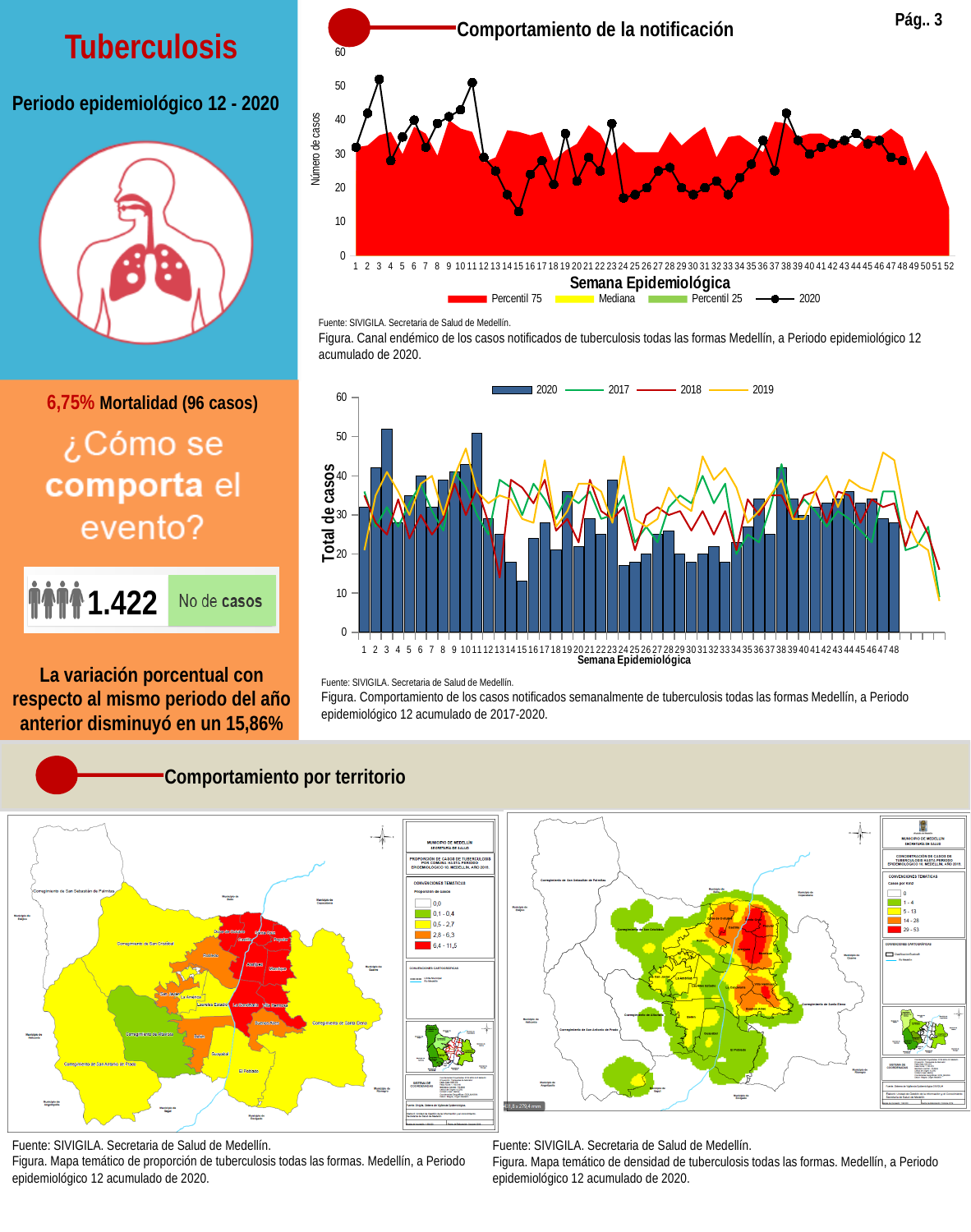
In the second chart (weekly cases 2017-2020), is the 2020 bar for week 14 greater or less than 20? less In the chart titled 'Comportamiento de la notificación', what are the legend entries? Percentil 75, Mediana, Percentil 25, 2020 In the second chart (weekly cases 2017-2020), how many series does the legend list? 4 In the second chart (weekly cases 2017-2020), which year is plotted as bars? 2020 In the second chart (weekly cases 2017-2020), is the 2020 bar for week 3 greater or less than 50? greater In the second chart (weekly cases 2017-2020), how many weeks are labelled on the x axis? 48 In the second chart (weekly cases 2017-2020), which week has the lowest 2020 bar? 15 In the chart titled 'Comportamiento de la notificación', is the 2020 value for week 3 greater or less than 50? greater In the chart titled 'Comportamiento de la notificación', how many series does the legend list? 4 In the second chart (weekly cases 2017-2020), which is larger for 2020: week 3 or week 15? week 3 In the chart titled 'Comportamiento de la notificación', what is the label of the x axis? Semana Epidemiológica